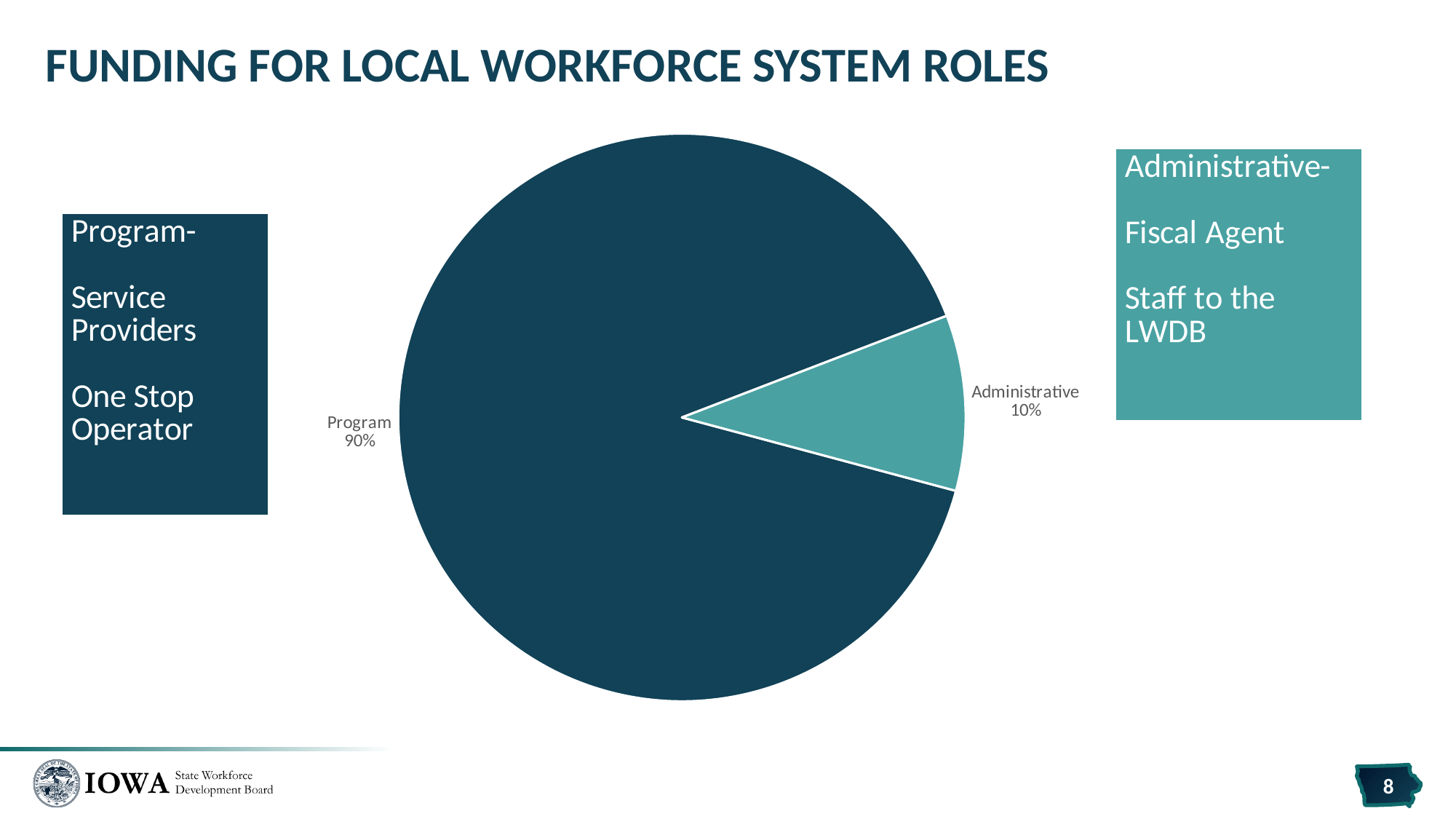
What is the difference in percentage points between the Program and Administrative slices? 80 What share of the pie does the Program slice represent? 90% Which slice of the pie is the smallest? Administrative Which slice of the pie is the largest? Program What colour is the Administrative slice of the pie? teal Is the Administrative share greater or less than 50%? less How many slices does the pie chart have? 2 What is the total of the two pie slice percentages? 100% What is the title of the slide containing the pie chart? FUNDING FOR LOCAL WORKFORCE SYSTEM ROLES Which is larger, the Program slice or the Administrative slice? Program What kind of chart is shown on the slide? pie chart What share of the pie does the Administrative slice represent? 10%